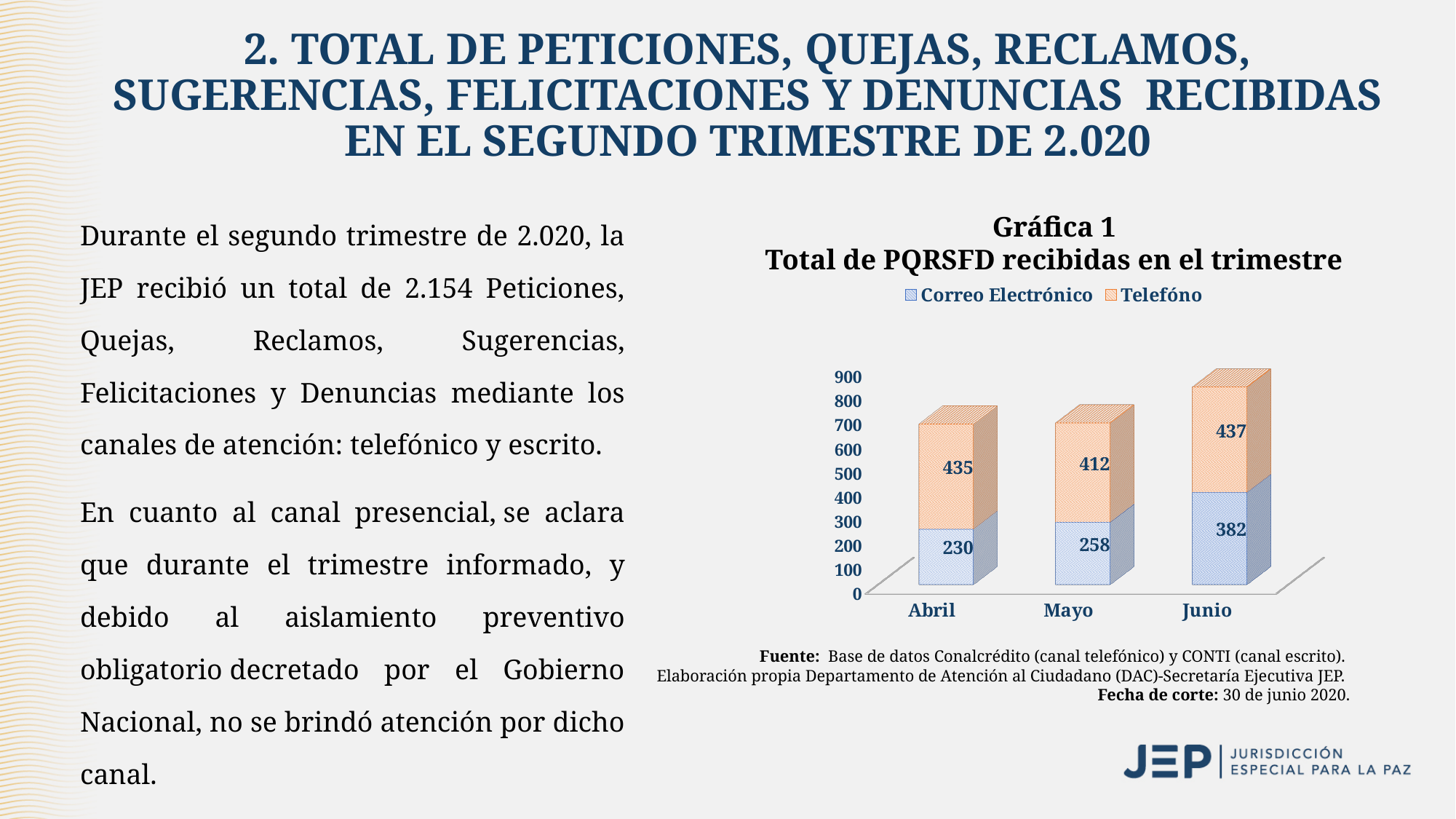
Which month has the highest value for Correo Electrónico? Junio What is the value for Telefóno in Junio? 437 What is the value for Correo Electrónico in Mayo? 258 How many series does the legend list? 2 How many months are shown on the x axis? 3 What is the value for Correo Electrónico in Abril? 230 What is the difference between the Correo Electrónico values for Junio and Abril? 152 What is the total of the stacked bar for Junio? 819 What is the total of the stacked bar for Abril? 665 Which month has the lowest value for Telefóno? Mayo Which is larger, the Telefóno value for Abril or for Mayo? Abril What kind of chart is shown? Stacked bar chart